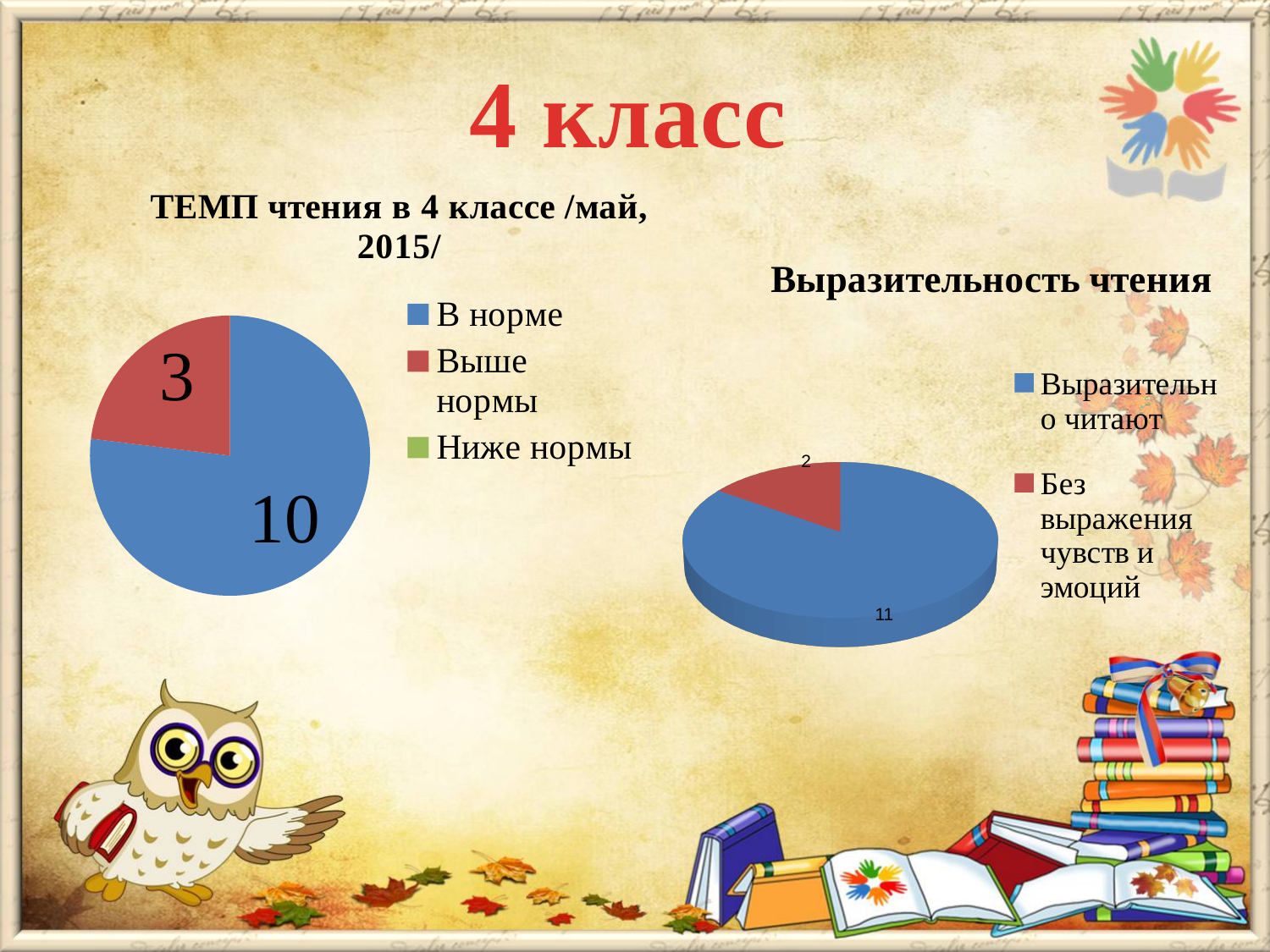
How many entries does the legend of the chart titled 'ТЕМП чтения в 4 классе /май, 2015/' list? 3 On the chart titled 'Выразительность чтения', what is the difference between the values for 'Выразительно читают' and 'Без выражения чувств и эмоций'? 9 On the chart titled 'Выразительность чтения', which is larger: 'Выразительно читают' or 'Без выражения чувств и эмоций'? Выразительно читают On the chart titled 'Выразительность чтения', which category has the smallest slice? Без выражения чувств и эмоций What kind of chart is the one titled 'Выразительность чтения'? Pie chart On the chart titled 'Выразительность чтения', what is the value for 'Без выражения чувств и эмоций'? 2 On the chart titled 'Выразительность чтения', what is the value for 'Выразительно читают'? 11 On the chart titled 'Выразительность чтения', what is the total of the two labelled slices? 13 On the chart titled 'ТЕМП чтения в 4 классе /май, 2015/', what is the value for 'Выше нормы'? 3 On the chart titled 'ТЕМП чтения в 4 классе /май, 2015/', what is the value for 'В норме'? 10 On the chart titled 'ТЕМП чтения в 4 классе /май, 2015/', which category has the largest slice? В норме On the chart titled 'ТЕМП чтения в 4 классе /май, 2015/', what is the difference between the values for 'В норме' and 'Выше нормы'? 7